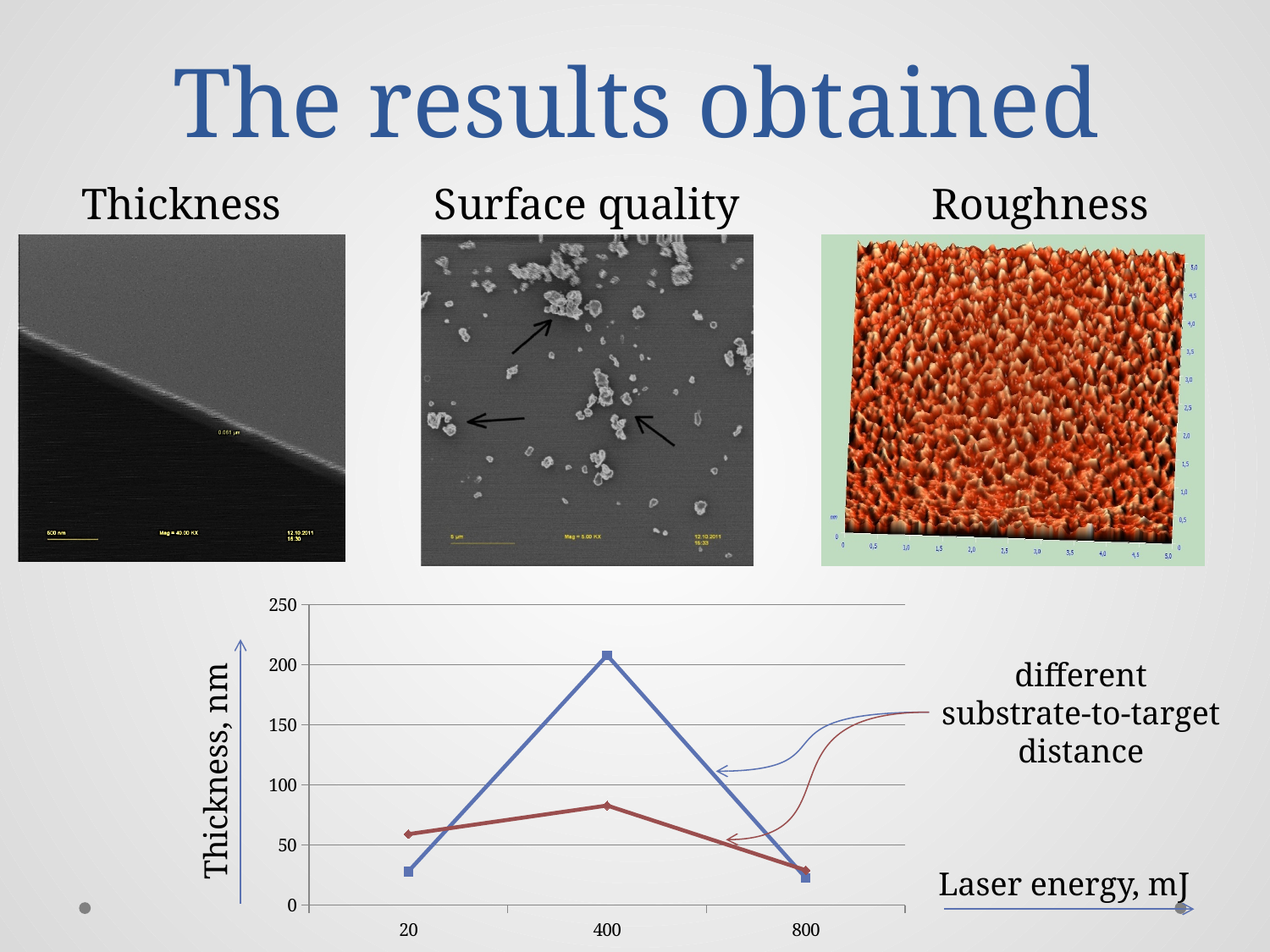
At 400 mJ, which line shows the larger thickness, the blue or the red? blue What is the label of the vertical axis of the line chart? Thickness, nm Is the thickness of the blue line at 20 mJ greater or less than 50? less At which laser energy does the blue line reach its highest thickness? 400 At 20 mJ, which line shows the larger thickness, the blue or the red? red Is the thickness of the blue line at 400 mJ greater or less than 200? greater What kind of chart is shown at the bottom of the slide? line chart How many laser energy values are marked on the x axis of the line chart? 3 Is the thickness of the red line at 400 mJ greater or less than 100? less At which laser energy does the red line reach its highest thickness? 400 What is the label of the horizontal axis of the line chart? Laser energy, mJ How many lines are plotted on the line chart? 2